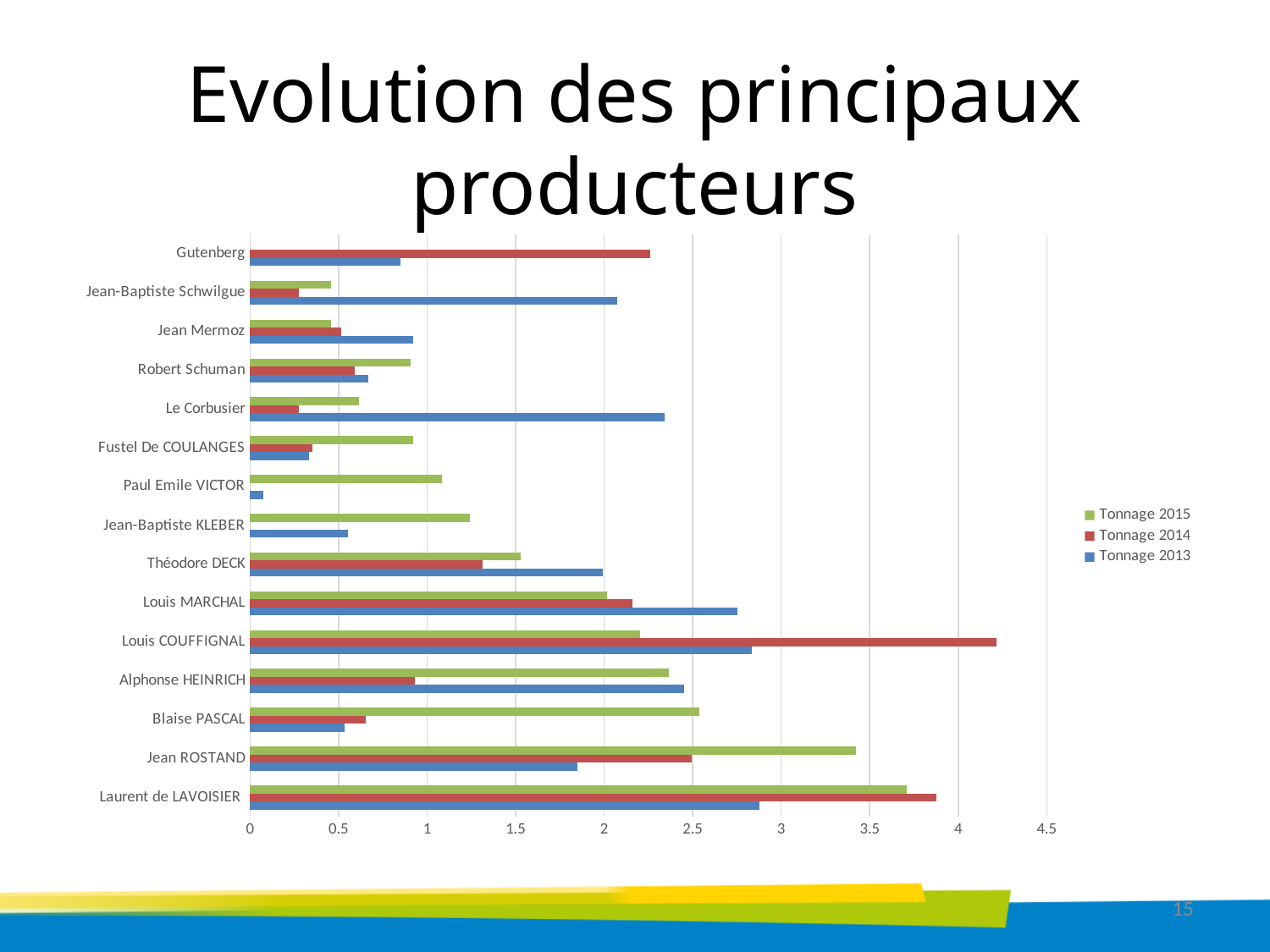
Is the Tonnage 2014 value for Louis COUFFIGNAL greater or less than 4? greater How many series does the legend list? 3 Which producer has the highest Tonnage 2014 value? Louis COUFFIGNAL Is the Tonnage 2013 value for Le Corbusier greater or less than 2? greater For Jean ROSTAND, which is larger: Tonnage 2015 or Tonnage 2014? Tonnage 2015 What kind of chart is shown on the slide? bar chart Is the Tonnage 2015 value for Jean ROSTAND greater or less than 3? greater For Le Corbusier, which is larger: Tonnage 2013 or Tonnage 2015? Tonnage 2013 What is the title of the slide containing the chart? Evolution des principaux producteurs How many producers (categories) are shown on the chart? 15 Which producer has the highest Tonnage 2015 value? Laurent de LAVOISIER